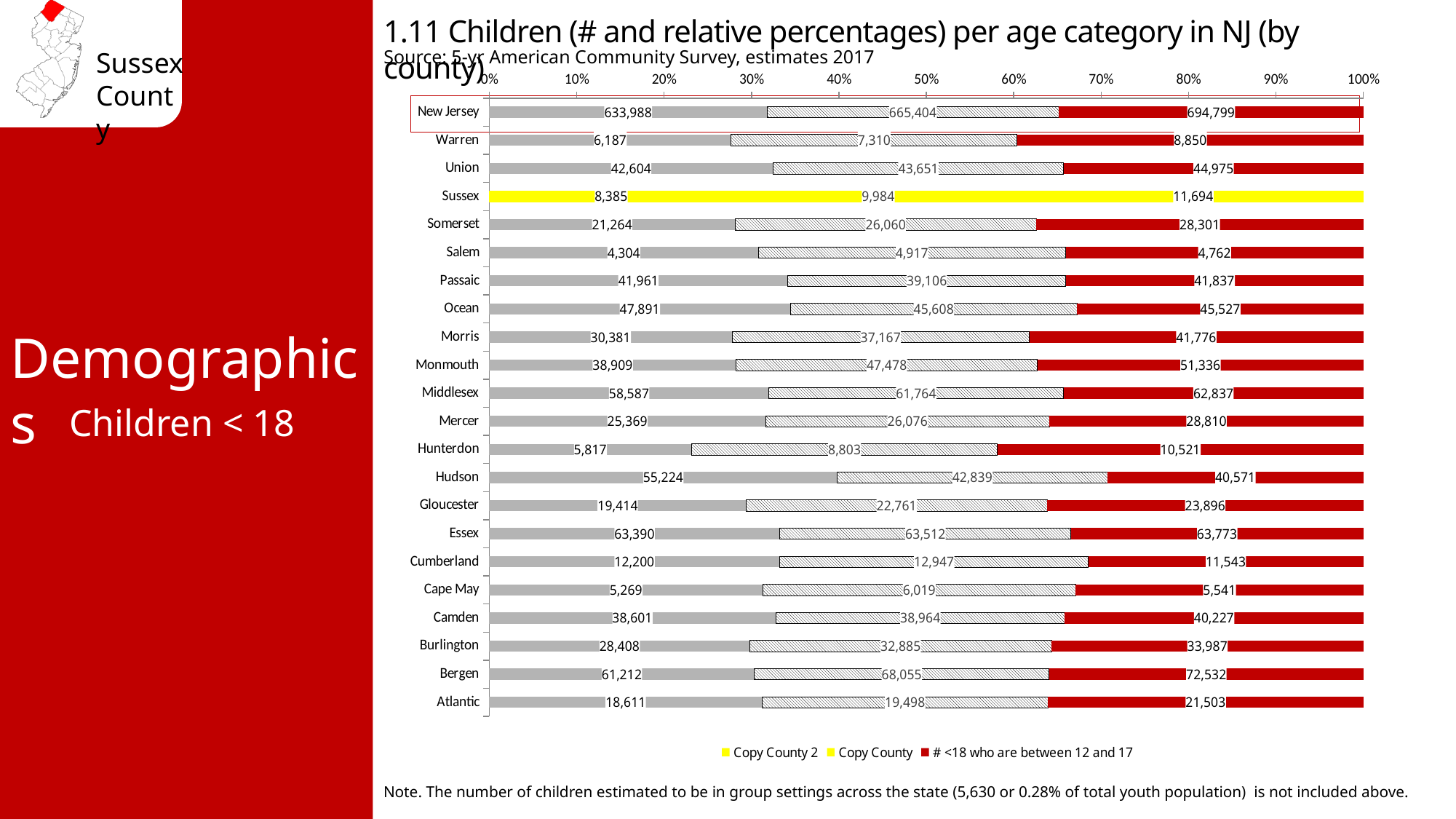
How many series does the legend list? 3 What kind of chart is shown on the slide? Stacked bar chart Which is larger for Hudson: the leftmost segment value or the rightmost (red) segment value? Leftmost segment (55,224) Among the counties, which has the lowest value for # <18 who are between 12 and 17? Salem Among the counties (excluding New Jersey), which has the highest value for # <18 who are between 12 and 17? Bergen How many bars (categories) are shown on the chart? 22 What is the value of the red segment (# <18 who are between 12 and 17) for New Jersey? 694,799 What is the total of the three segments of the Sussex bar? 30,063 What is the value of the leftmost segment of the Sussex bar? 8,385 What is the difference between the rightmost and leftmost segment values for Sussex? 3,309 What is the value of the middle segment of the Warren bar? 7,310 What is the value of the rightmost segment (# <18 who are between 12 and 17) for Sussex? 11,694